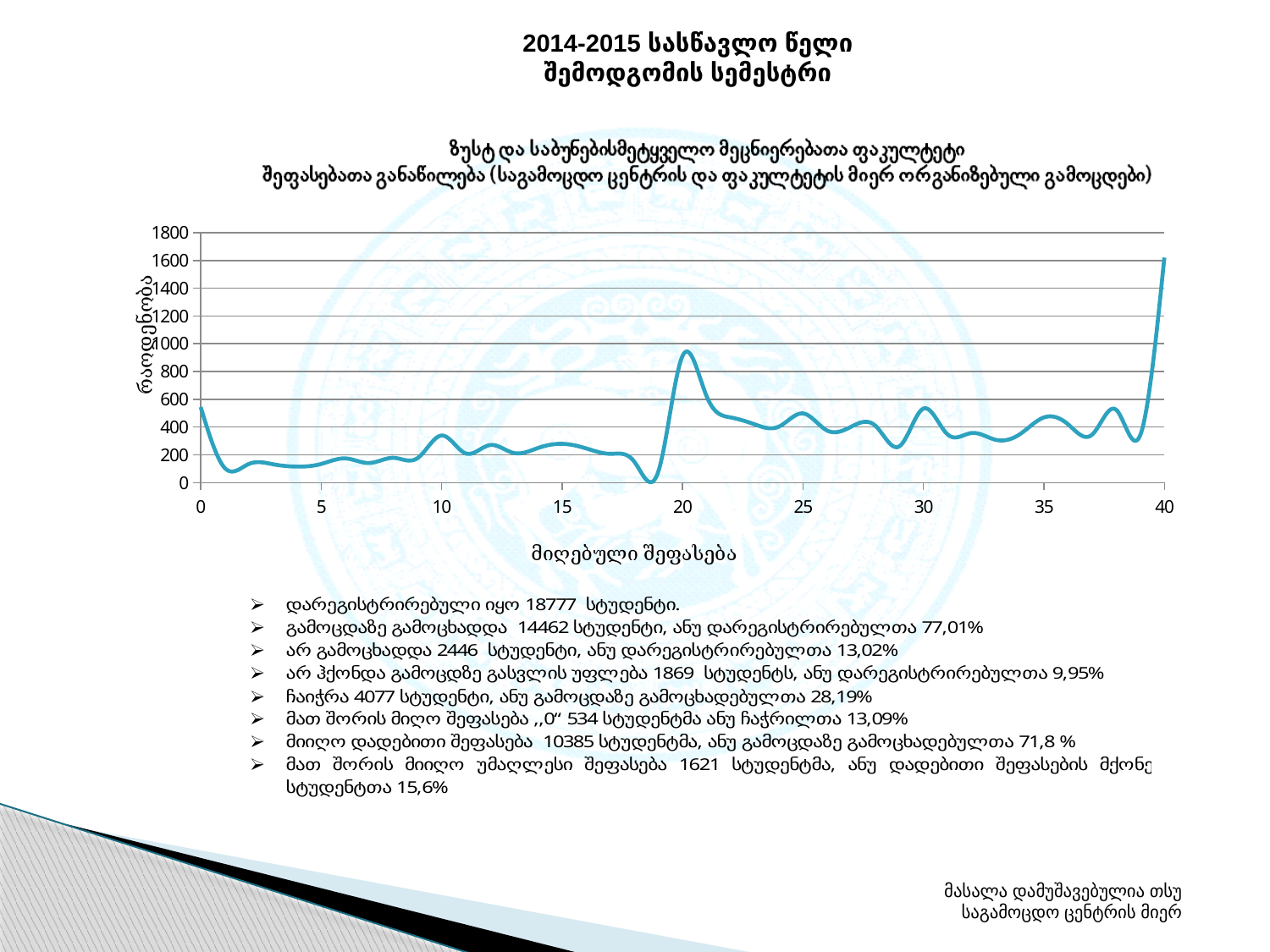
What is the highest tick value shown on the y axis? 1800 Does the line end higher or lower at x = 40 than it starts at x = 0? higher Around which x-axis value does the line drop to its lowest point, near 0? 19 Is the value of the line at x = 10 greater or less than 600? less Is the value of the line at x = 30 greater or less than 400? greater What kind of chart is shown on the slide? line chart Is the value of the line at x = 20 greater or less than 600? greater Which is larger, the value of the line at x = 40 or at x = 20? x = 40 Which is larger, the value of the line at x = 20 or at x = 10? x = 20 At which x-axis value does the line reach its highest point? 40